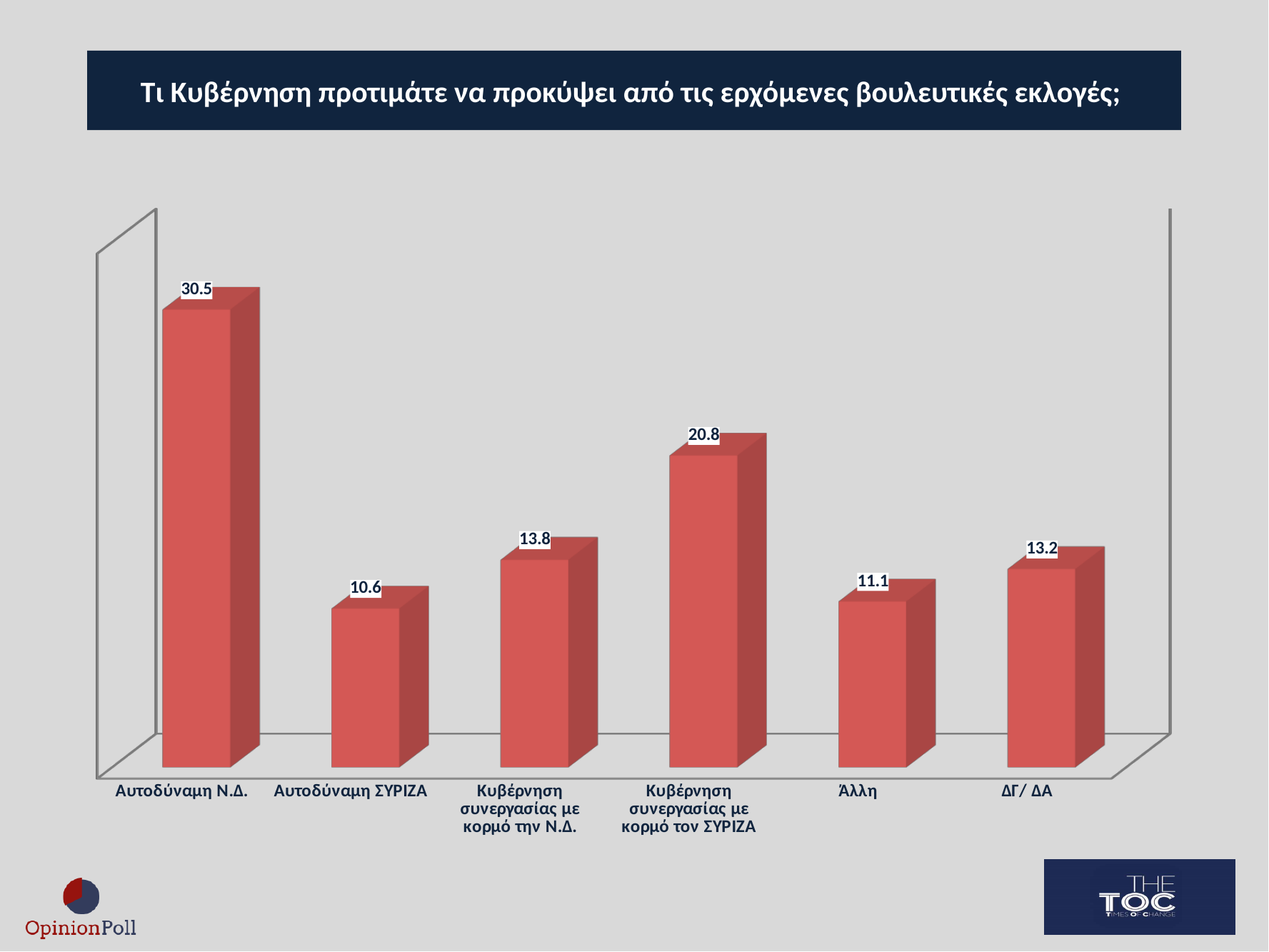
What is the value for Αυτοδύναμη Ν.Δ.? 30.5 What is the difference between the values for Κυβέρνηση συνεργασίας με κορμό την Ν.Δ. and Άλλη? 2.7 What is the difference between the values for Αυτοδύναμη Ν.Δ. and Κυβέρνηση συνεργασίας με κορμό τον ΣΥΡΙΖΑ? 9.7 Which category has the highest value? Αυτοδύναμη Ν.Δ. What is the value for Αυτοδύναμη ΣΥΡΙΖΑ? 10.6 What is the value for ΔΓ/ ΔΑ? 13.2 Which category has the lowest value? Αυτοδύναμη ΣΥΡΙΖΑ What is the title of the chart? Τι Κυβέρνηση προτιμάτε να προκύψει από τις ερχόμενες βουλευτικές εκλογές; What is the value for Κυβέρνηση συνεργασίας με κορμό τον ΣΥΡΙΖΑ? 20.8 How many categories are shown in the chart? 6 Which is larger, the value for Κυβέρνηση συνεργασίας με κορμό την Ν.Δ. or the value for ΔΓ/ ΔΑ? Κυβέρνηση συνεργασίας με κορμό την Ν.Δ. What kind of chart is shown on the slide? Bar chart